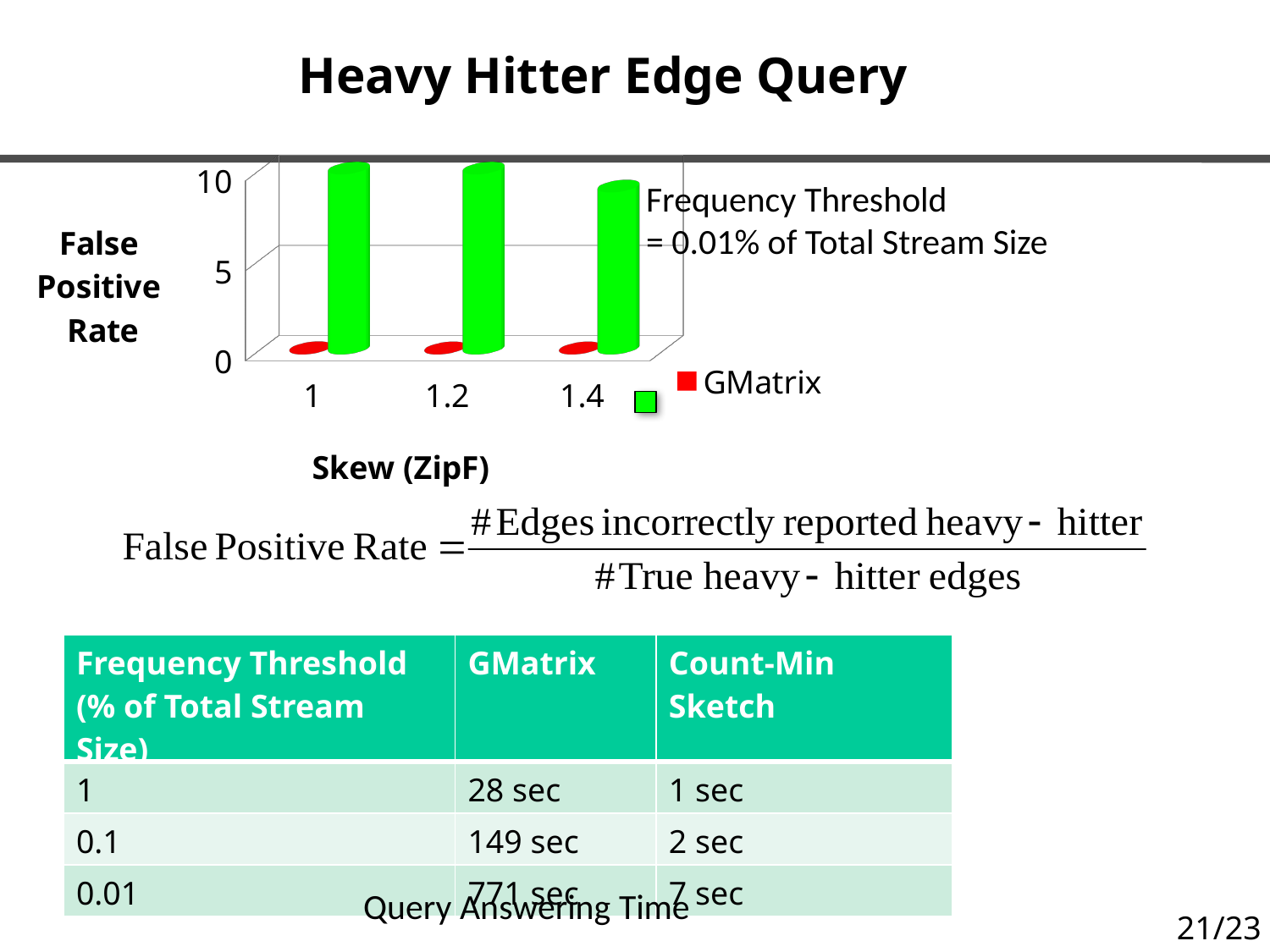
Is the value of the green bar at skew 1.2 greater or less than 5? greater Is the GMatrix value at skew 1 greater or less than 5? less Is the GMatrix value at skew 1.4 greater or less than 5? less What kind of chart is shown on the slide? bar chart What is the title of the x axis of the chart? Skew (ZipF) How many skew categories are shown on the x axis of the chart? 3 Which skew category has the lowest value for the green bars? 1.4 At skew 1.4, which is larger: the GMatrix value or the green bar's value? the green bar At skew 1.2, which is larger: the GMatrix value or the green bar's value? the green bar What quantity is plotted on the y axis of the chart? False Positive Rate